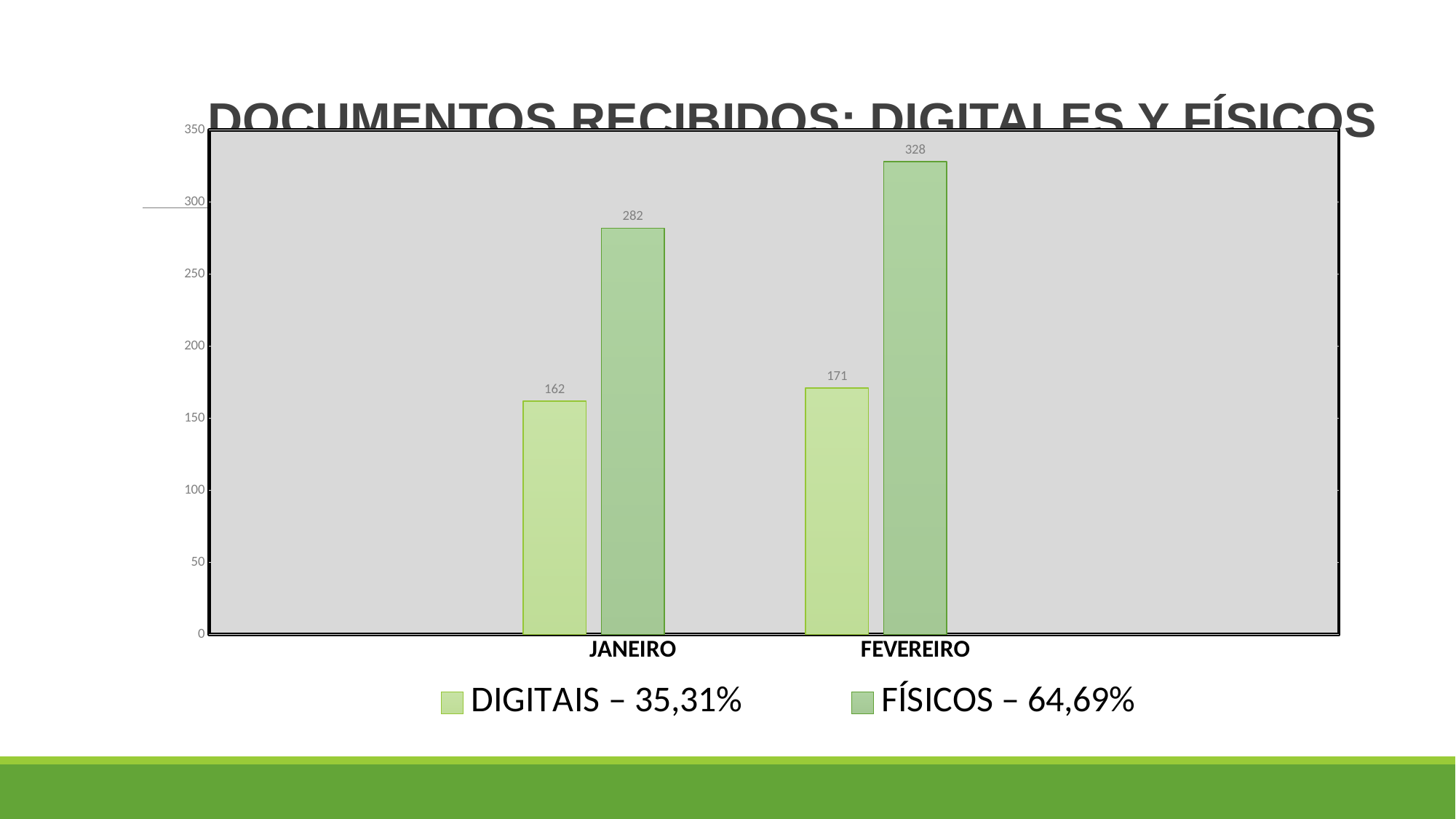
What is the difference between FÍSICOS and DIGITAIS in JANEIRO? 120 What is the value for FÍSICOS in FEVEREIRO? 328 What is the value for FÍSICOS in JANEIRO? 282 What kind of chart is shown on the slide? Bar chart What is the value for DIGITAIS in FEVEREIRO? 171 How many series does the legend list? 2 What is the value for DIGITAIS in JANEIRO? 162 Which is larger: DIGITAIS in FEVEREIRO or FÍSICOS in JANEIRO? FÍSICOS in JANEIRO How many categories are shown on the x axis? 2 Which bar has the lowest value on the chart? DIGITAIS in JANEIRO Which bar has the highest value on the chart? FÍSICOS in FEVEREIRO What is the difference between FÍSICOS in FEVEREIRO and FÍSICOS in JANEIRO? 46